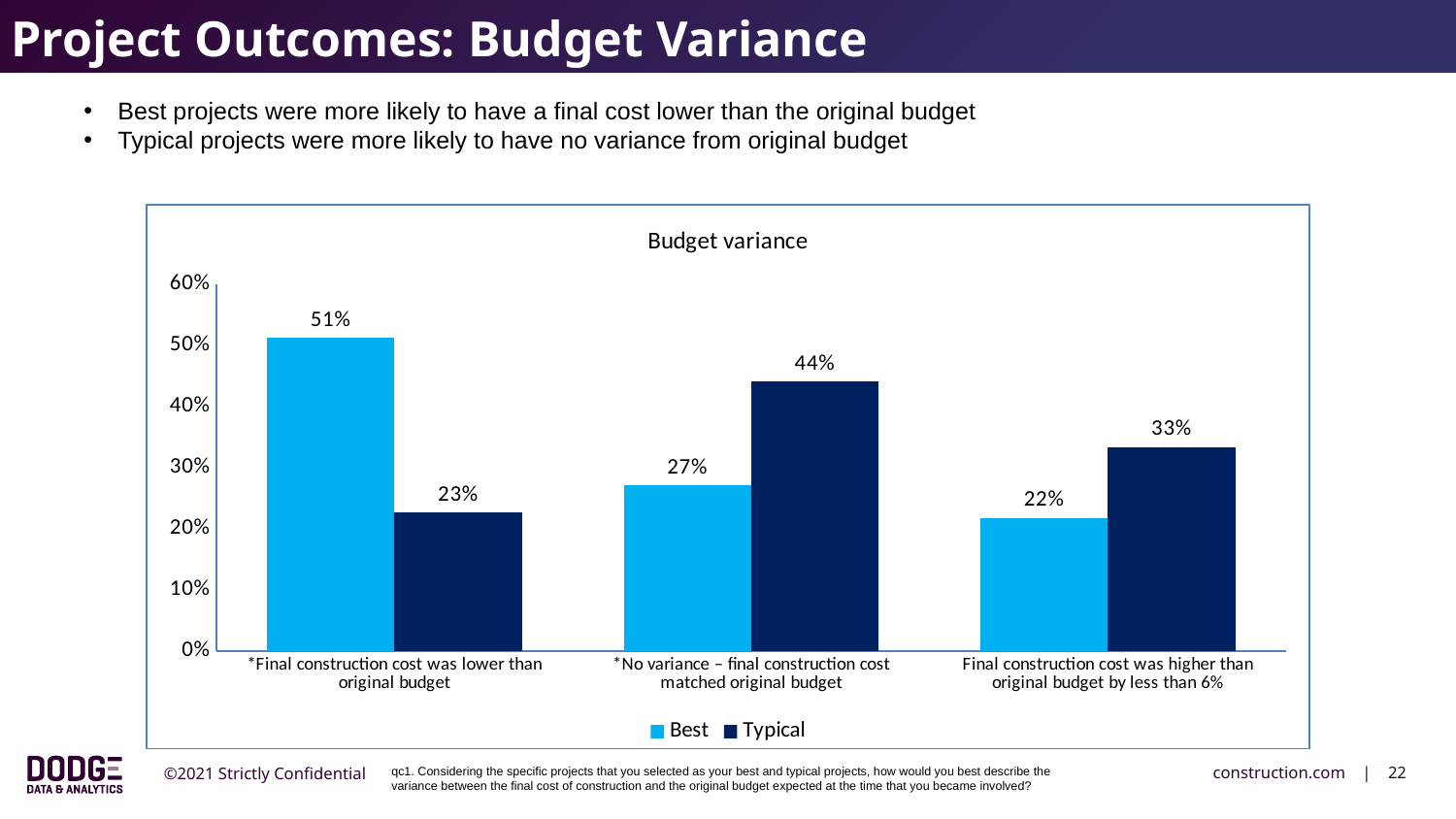
Is the Typical value for 'Final construction cost was higher than original budget by less than 6%' greater or less than 30%? greater What is the value for Typical projects in the 'No variance – final construction cost matched original budget' category? 44% What is the title of the chart? Budget variance How many series does the legend list? 2 What is the value for Best projects in the 'Final construction cost was lower than original budget' category? 51% What is the value for Best projects in the 'Final construction cost was higher than original budget by less than 6%' category? 22% What is the difference between the Best and Typical values in the 'Final construction cost was lower than original budget' category? 28% In the 'No variance' category, which series has the larger value, Best or Typical? Typical What kind of chart is shown on the slide? Bar chart How many categories are shown on the x axis of the chart? 3 Which category has the highest value for the Best series? Final construction cost was lower than original budget Which category has the lowest value for the Typical series? Final construction cost was lower than original budget